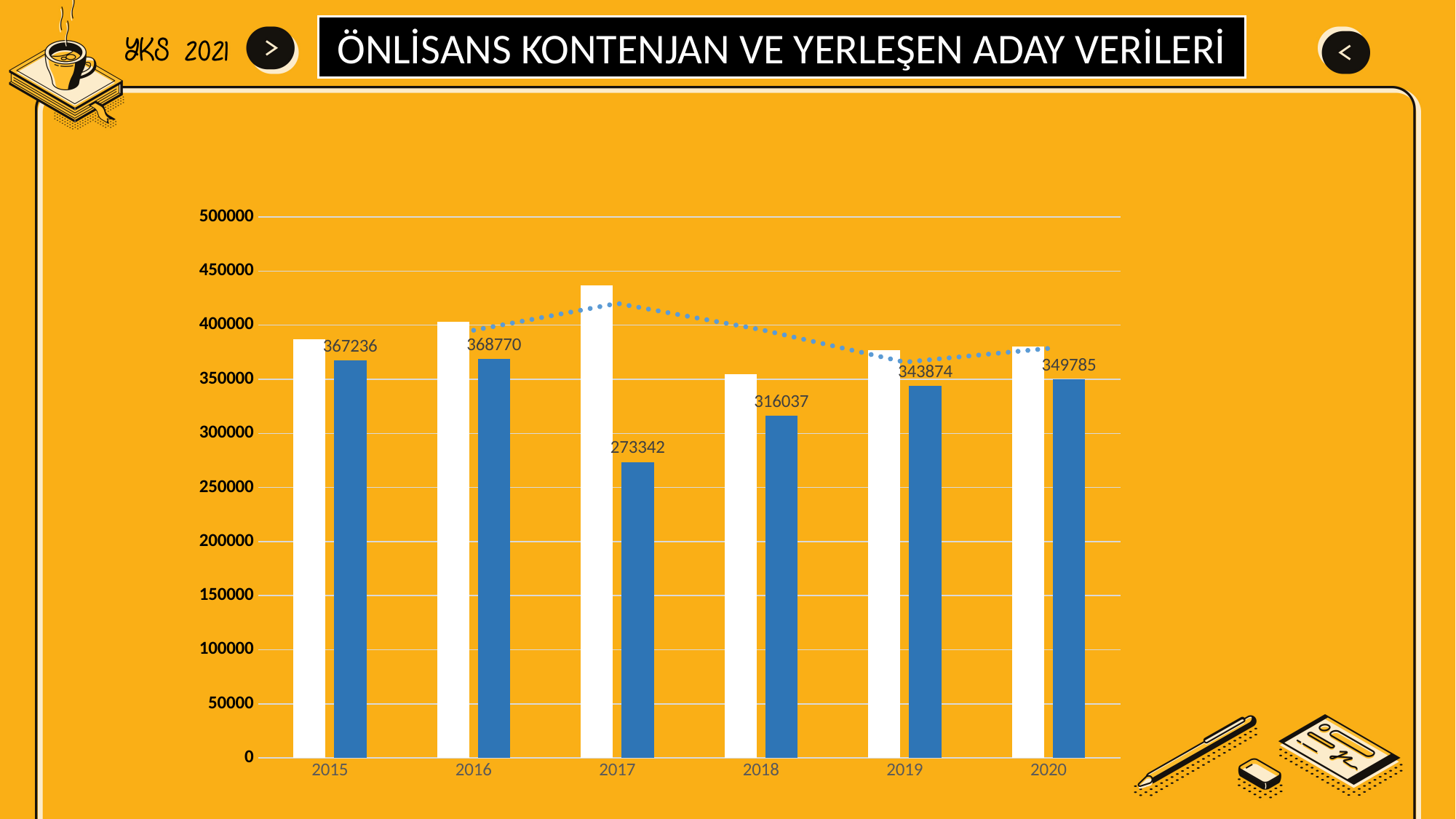
Is the value of the white bar for 2017 greater or less than 400000? greater What is the difference between the labelled blue bar values for 2020 and 2019? 5911 What is the labelled value of the blue bar for 2017? 273342 How many years are shown on the x axis? 6 What kind of chart is shown on the slide? bar chart Which is larger, the labelled blue bar value for 2018 or for 2019? 2019 Is the value of the white bar for 2018 greater or less than 400000? less Which year has the highest labelled blue bar value? 2016 What is the labelled value of the blue bar for 2018? 316037 Which year has the lowest labelled blue bar value? 2017 What is the difference between the labelled blue bar values for 2016 and 2015? 1534 What is the labelled value of the blue bar for 2020? 349785